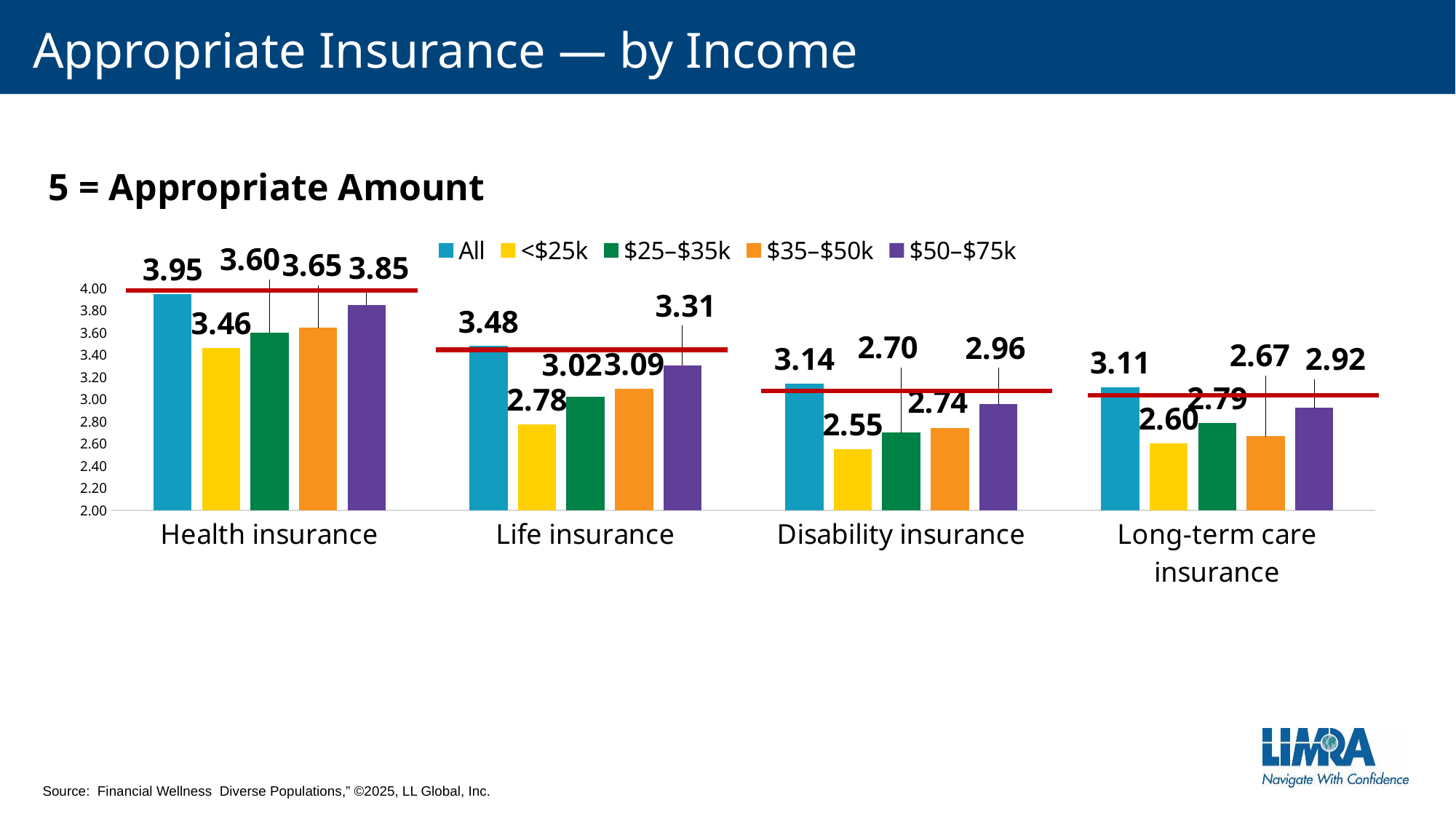
Which insurance type has the highest value for All? Health insurance How many insurance categories are shown on the x axis? 4 What is the value for $35–$50k for Long-term care insurance? 2.67 How many series does the legend list? 5 What kind of chart is shown on the slide? Bar chart What is the value for All for Health insurance? 3.95 What is the value for <$25k for Life insurance? 2.78 Is the value for <$25k for Disability insurance greater or less than 2.60? less What is the value for $50–$75k for Disability insurance? 2.96 Which income group has the lowest value for Disability insurance? <$25k What is the difference between the All value and the <$25k value for Health insurance? 0.49 Which is larger for Long-term care insurance: the $25–$35k value or the $35–$50k value? $25–$35k